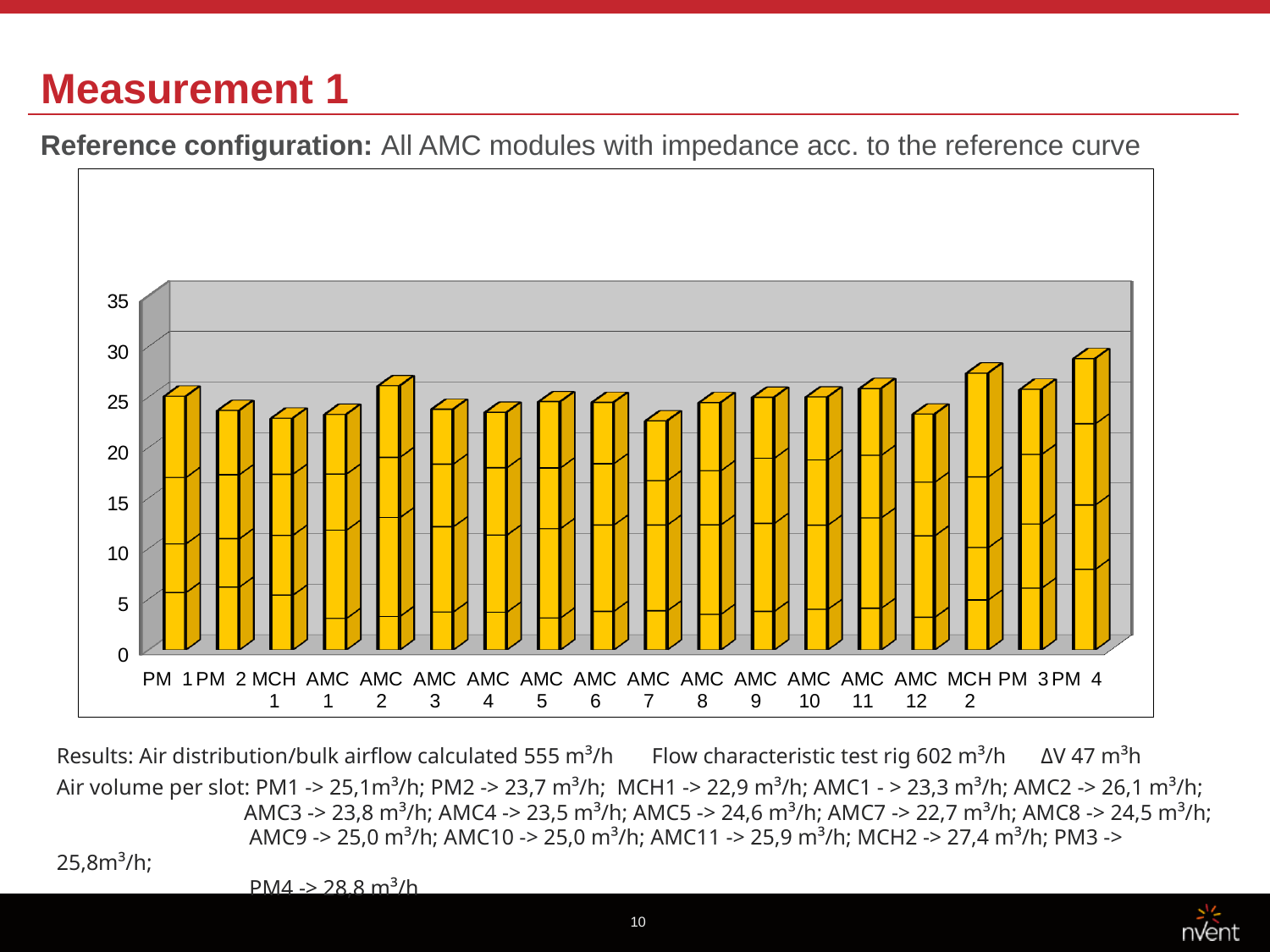
According to the air volume per slot listed on the slide, what is the value for MCH2? 27,4 m³/h Is the value for AMC 12 greater or less than 25? less Is the value for MCH 2 greater or less than 25? greater Which bar is taller, AMC 2 or AMC 3? AMC 2 What is the highest value shown on the chart's vertical axis? 35 According to the air volume per slot listed on the slide, what is the value for PM4? 28,8 m³/h Which slot has the highest bar in the chart? PM 4 What kind of chart is shown on the slide? bar chart How many categories (slots) are plotted along the x axis of the chart? 18 Which bar is taller, PM 4 or PM 1? PM 4 Is the value for PM 4 greater or less than 25? greater